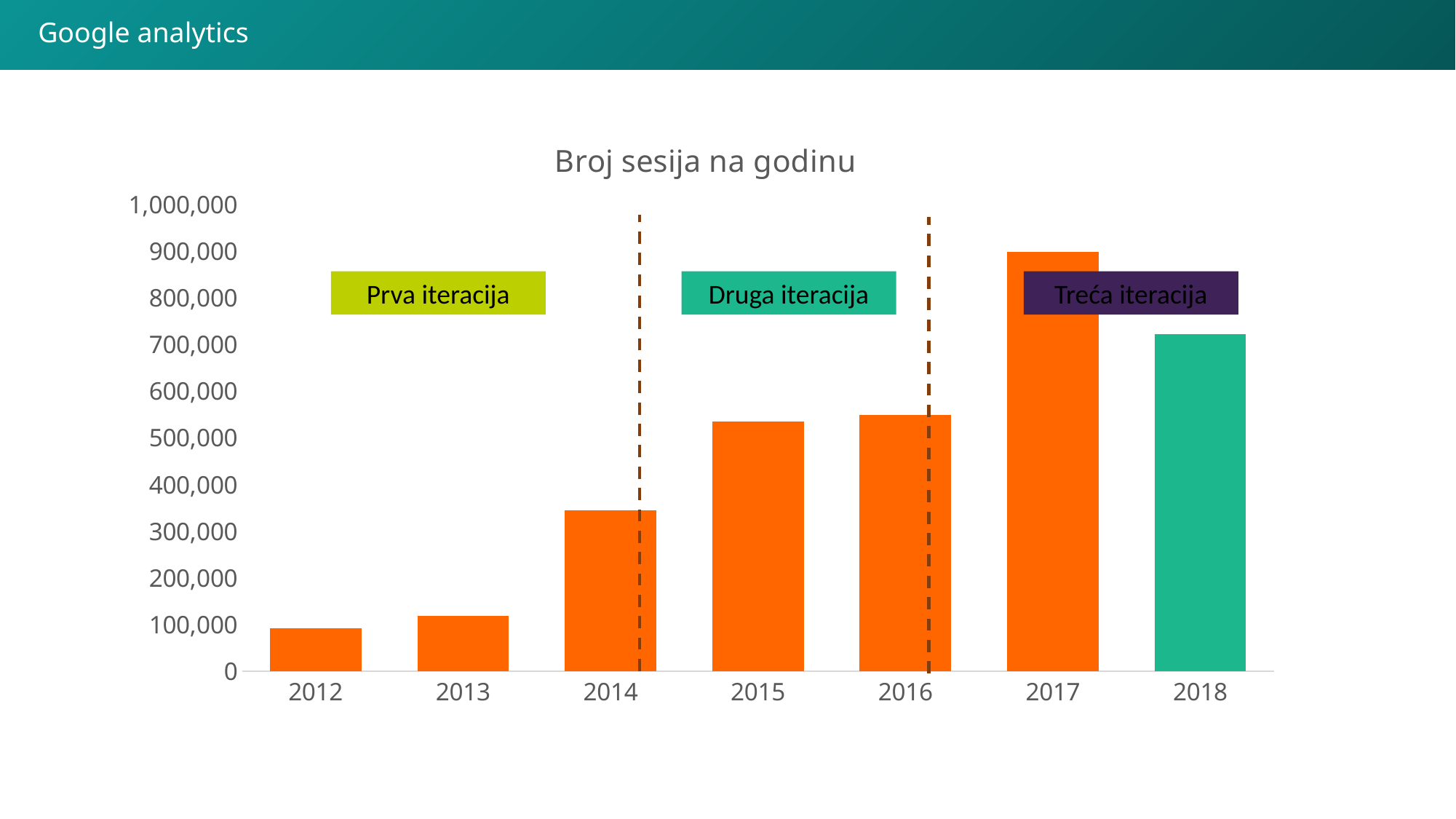
Is the value for 2018 greater or less than 700,000? greater How many years are shown on the x axis of the chart? 7 Is the value for 2013 greater or less than 200,000? less What kind of chart is shown on the slide? bar chart Which year's bar is shown in a different colour (teal) from the others? 2018 Which year has the highest number of sessions? 2017 Is the value for 2014 greater or less than 300,000? greater Which year has more sessions, 2014 or 2015? 2015 What is the title of the chart? Broj sesija na godinu Which year has the lowest number of sessions? 2012